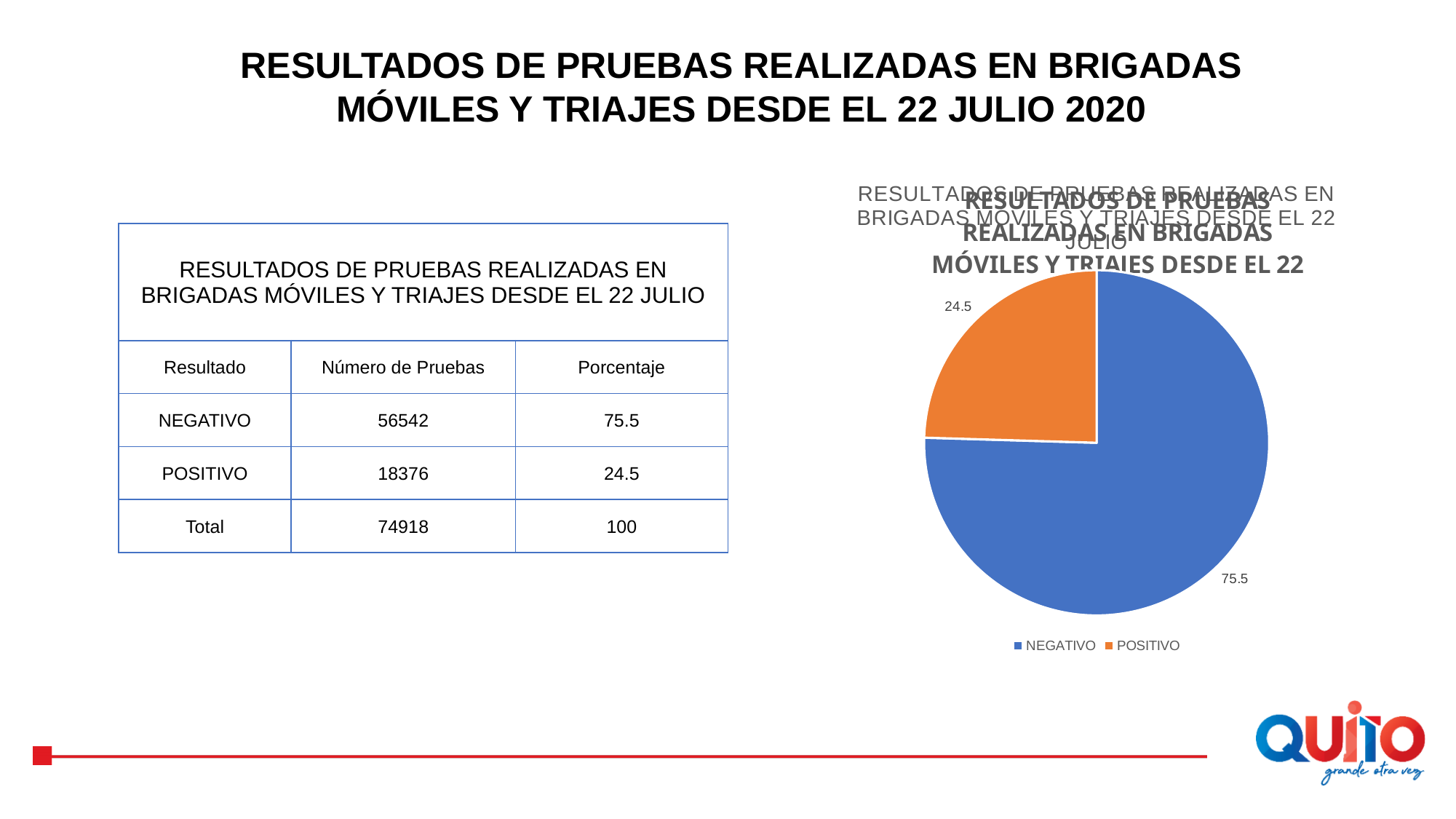
How many entries does the pie chart legend list? 2 Which slice of the pie chart is the smallest? POSITIVO What share of the pie does the POSITIVO slice represent? 24.5 What colour is the POSITIVO slice in the pie chart? orange What is the value shown for the POSITIVO slice in the pie chart? 24.5 How many slices does the pie chart have? 2 What is the value shown for the NEGATIVO slice in the pie chart? 75.5 Which slice of the pie chart is the largest? NEGATIVO What kind of chart is shown on the slide? pie chart What colour is the NEGATIVO slice in the pie chart? blue What is the difference between the NEGATIVO and POSITIVO values in the pie chart? 51 Which is larger in the pie chart, NEGATIVO or POSITIVO? NEGATIVO